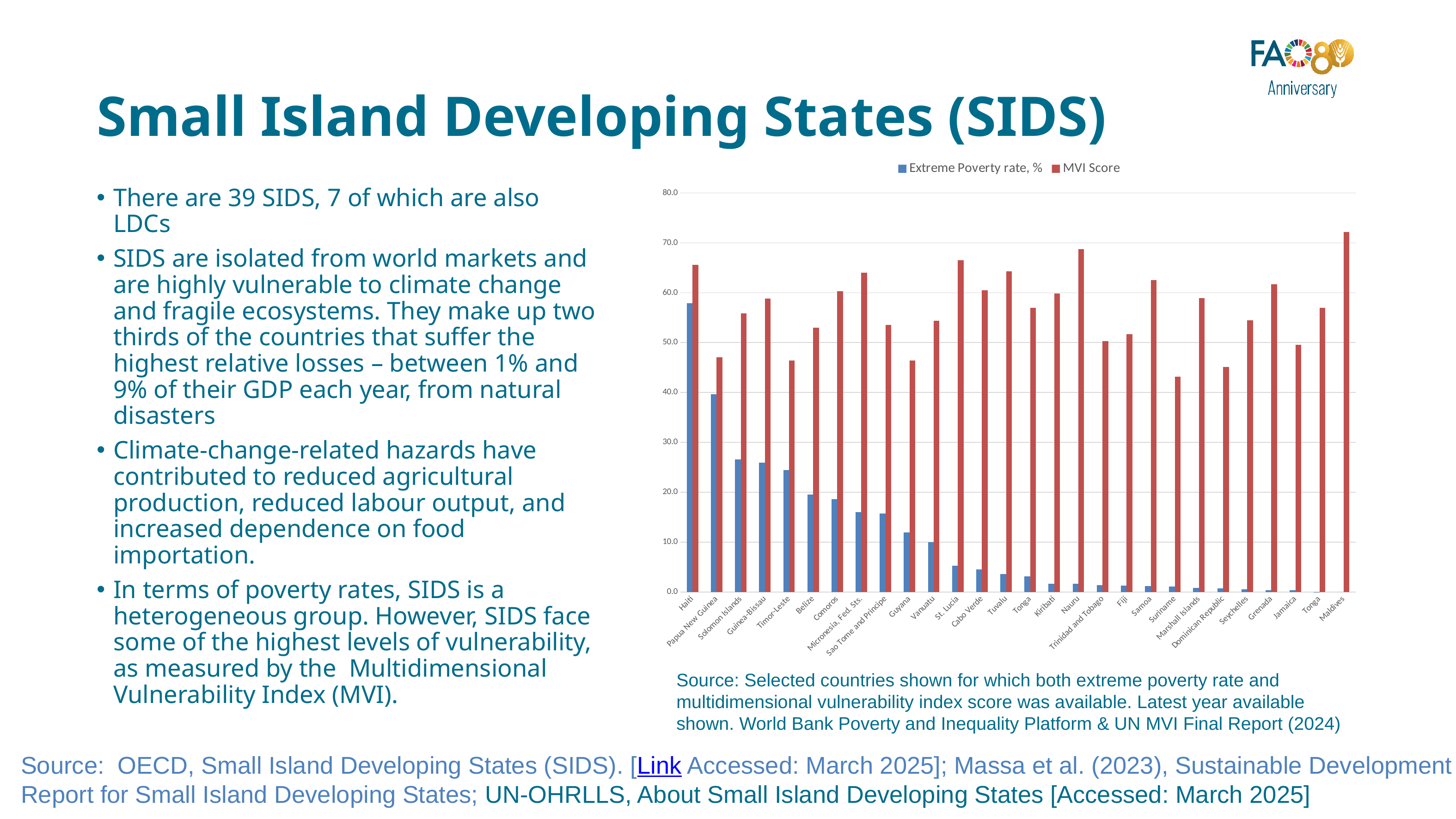
Is the MVI Score for Suriname greater or less than 50? less Is the MVI Score for Maldives greater or less than 60? greater Which country has the highest Extreme Poverty rate in the chart? Haiti Is the Extreme Poverty rate for Haiti greater or less than 50? greater How many series does the chart legend list? 2 Does the Extreme Poverty rate generally rise or fall moving from left to right along the x axis? fall Which country has the highest MVI Score in the chart? Maldives How many countries are shown on the x axis of the chart? 28 What kind of chart is shown on the slide? bar chart Which is larger, the MVI Score for Haiti or the MVI Score for Papua New Guinea? Haiti What are the two series named in the chart legend? Extreme Poverty rate, % and MVI Score